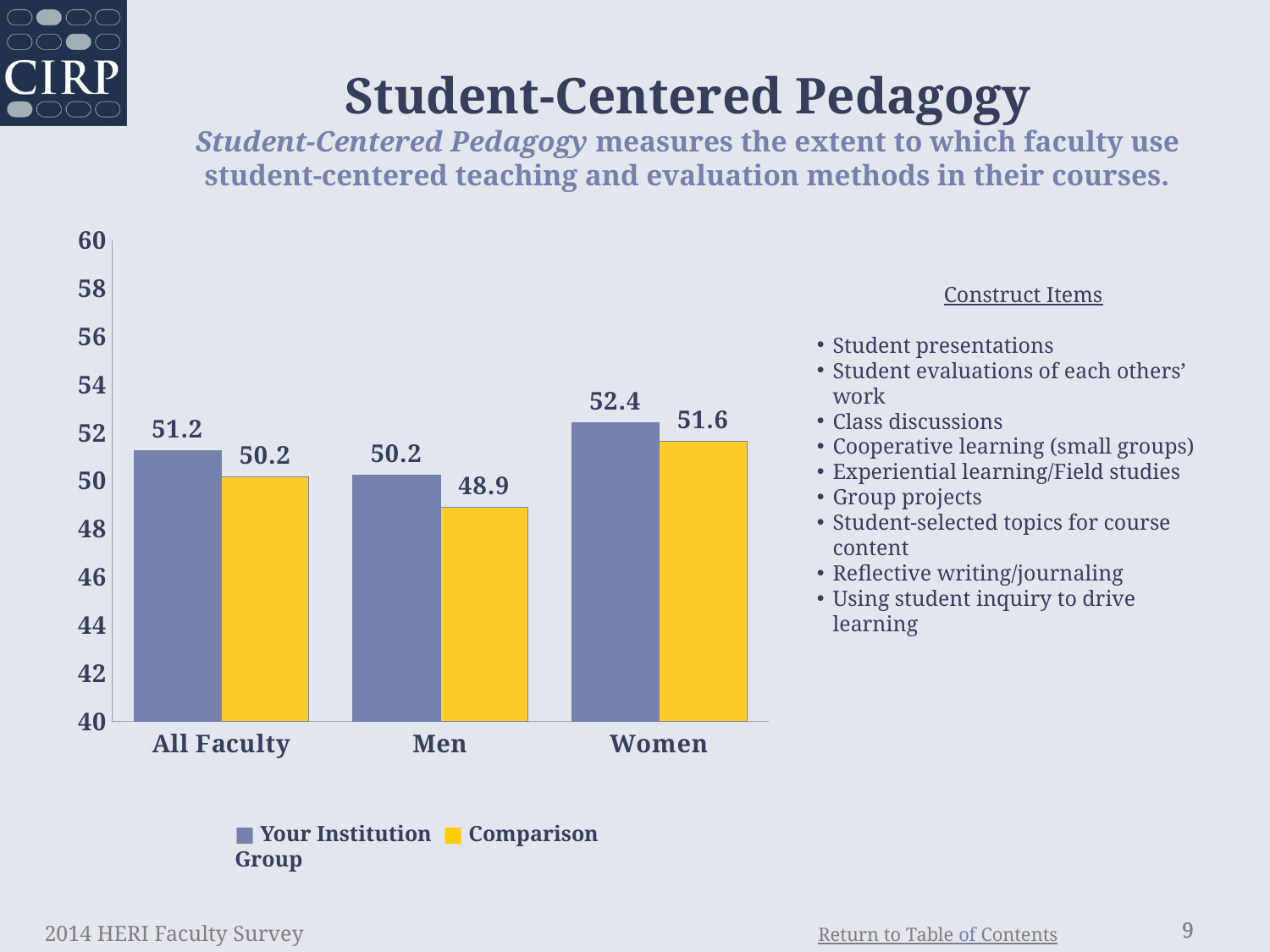
What is the difference between Your Institution and Comparison Group in the Men category? 1.3 What is the value for Your Institution in the Women category? 52.4 Which is larger in the All Faculty category, Your Institution or Comparison Group? Your Institution What is the value for Comparison Group in the Women category? 51.6 How many series does the legend list? 2 What is the value for Comparison Group in the Men category? 48.9 Which category has the lowest value for Comparison Group? Men How many categories are shown on the x axis? 3 What is the value for Your Institution in the All Faculty category? 51.2 What colour are the Comparison Group bars? Yellow Which category has the highest value for Your Institution? Women What kind of chart is shown on the slide? Bar chart